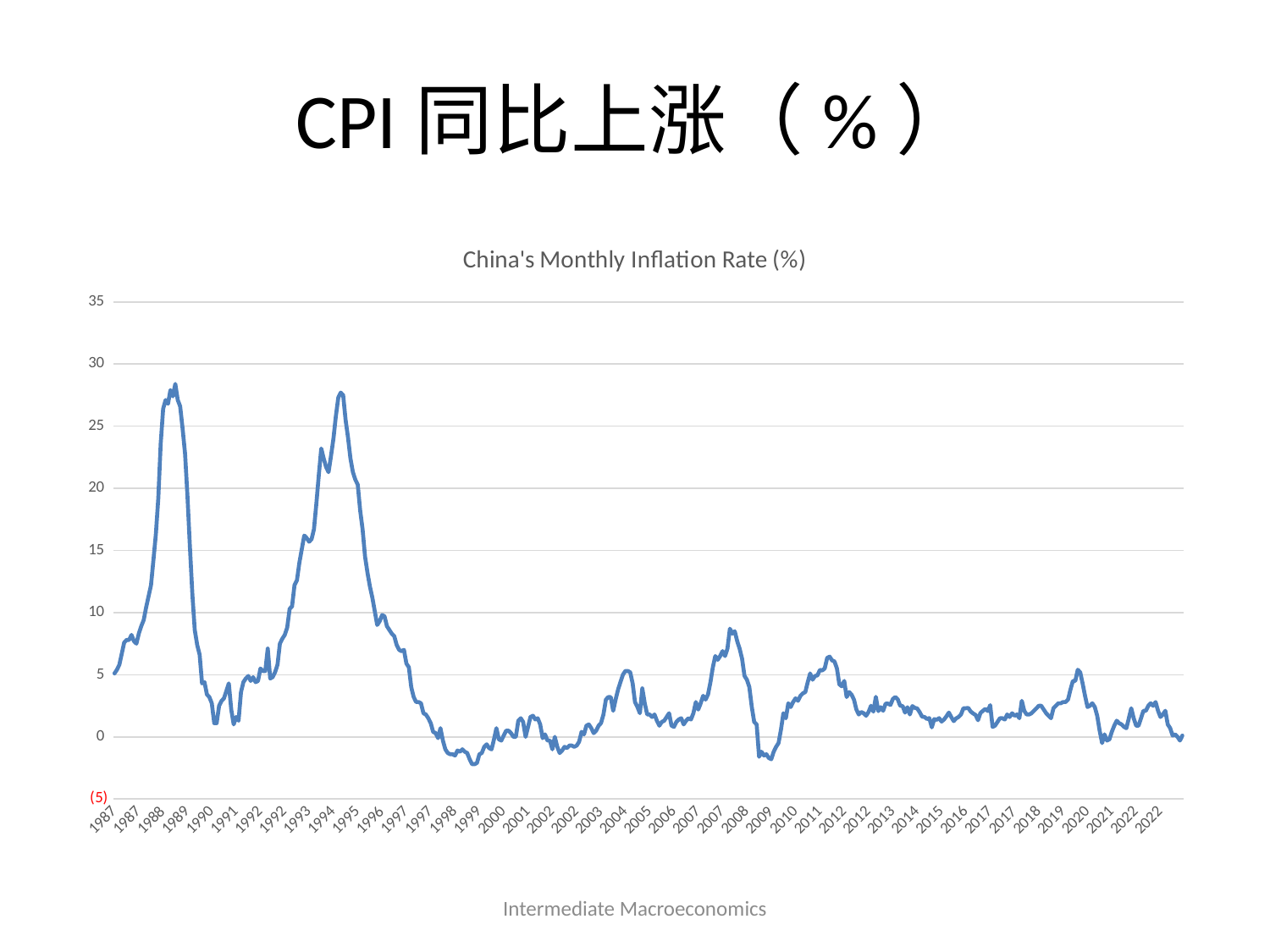
Does the inflation rate rise or fall between 1994 and 1999? fall What is the highest value shown on the vertical axis? 35 What kind of chart is shown on the slide? line chart Is the peak inflation rate around 2011 greater or less than 5? greater Is the inflation rate around 1999 greater or less than 5? less Which period has the higher peak inflation rate, around 1989 or around 2008? around 1989 What is the title of the chart? China's Monthly Inflation Rate (%) Does the inflation rate rise or fall between 1990 and 1994? rise Is the peak inflation rate reached around 1994 greater or less than 25? greater